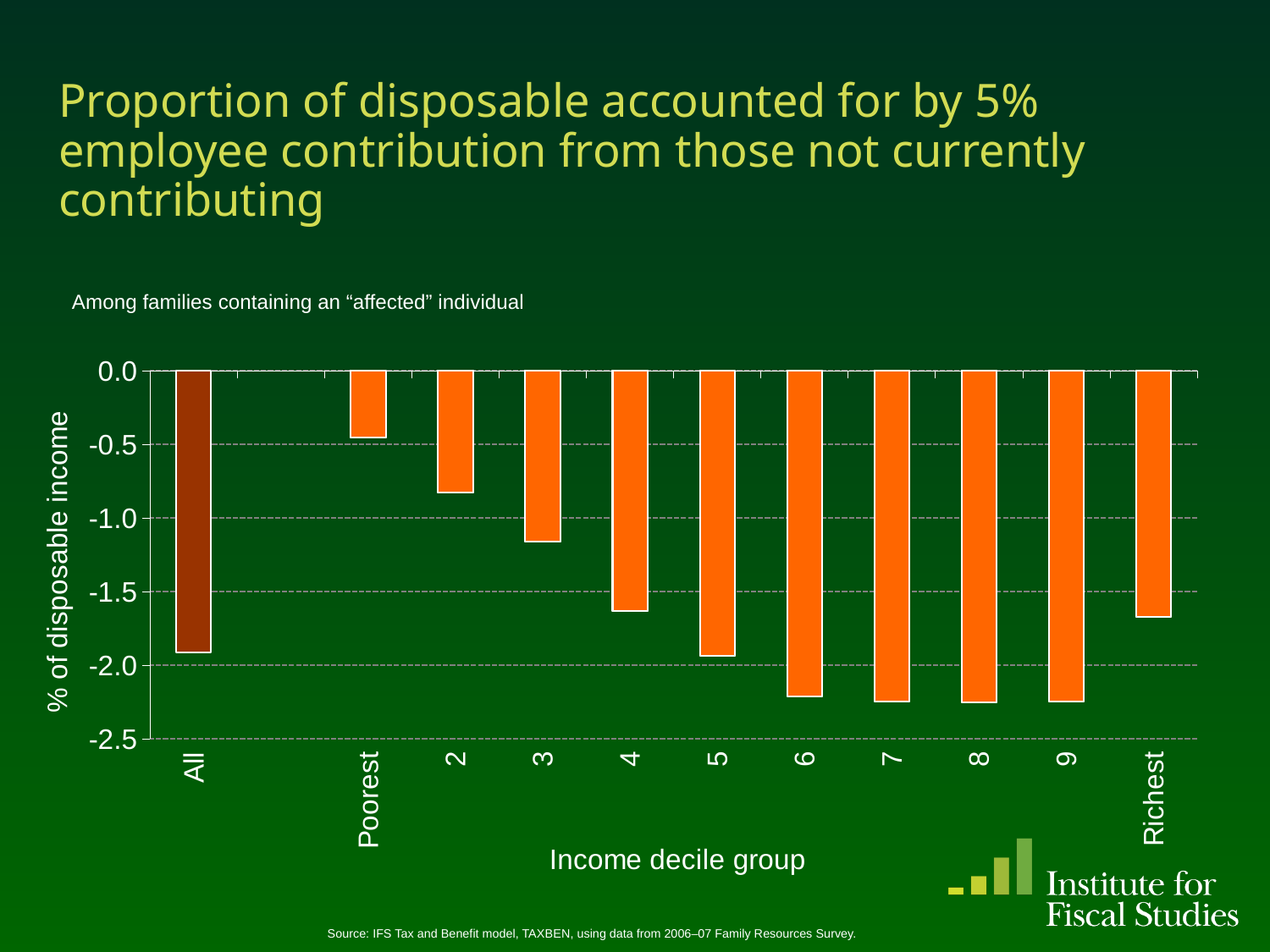
Is the value for decile group 2 greater or less than -0.5? less Which category has the highest (least negative) value on the chart? Poorest Is the value for decile group 3 greater or less than -1.0? less Is the value for the Richest decile greater or less than -2.0? greater Moving from the Poorest decile to decile 9, do the values rise or fall? fall What is the label on the y axis? % of disposable income What is the label on the x axis? Income decile group What kind of chart is shown on the slide? bar chart How many bars (categories) are plotted on the chart? 11 Which has the larger loss as a share of disposable income, the Poorest decile or the Richest decile? Richest